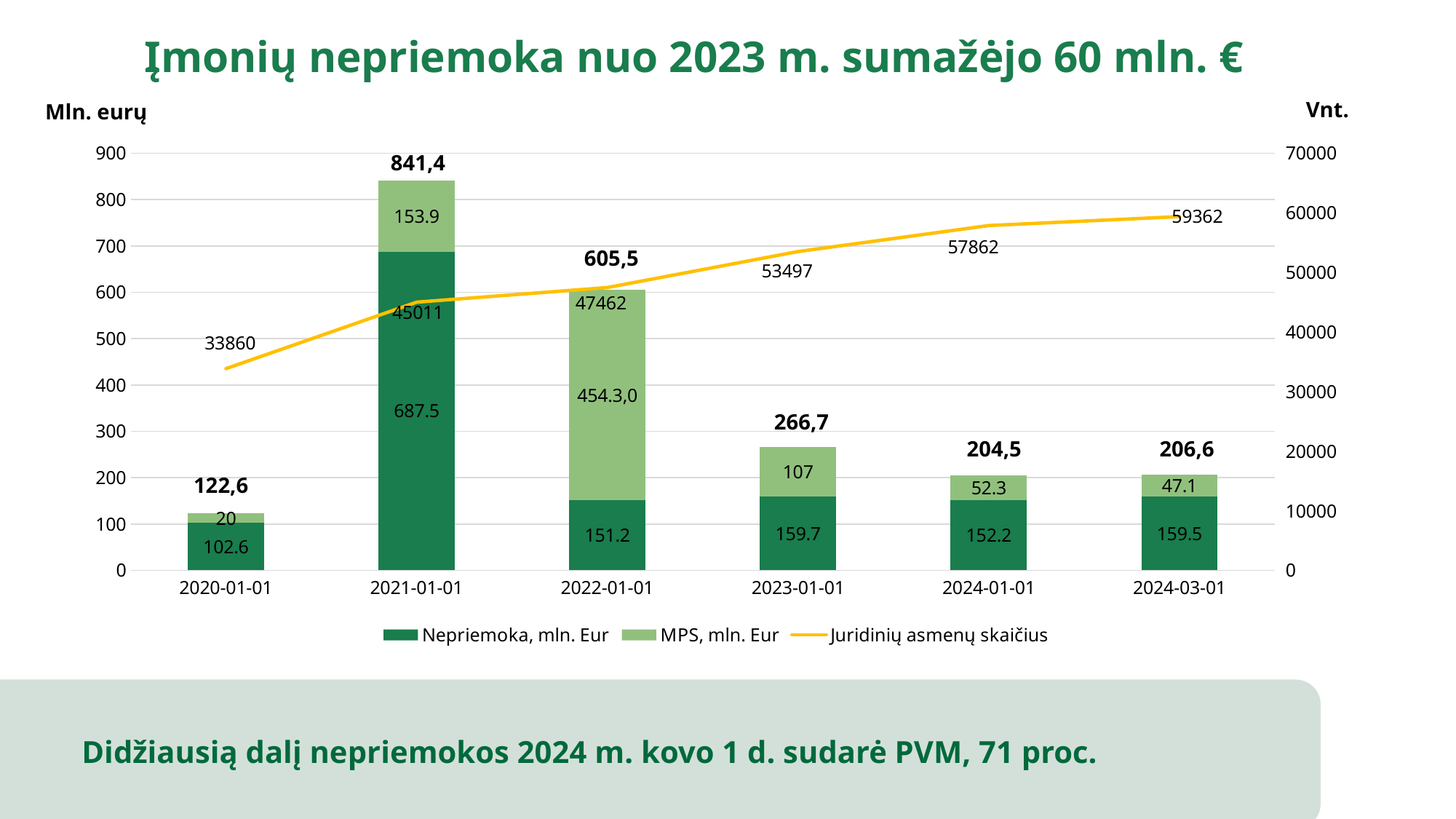
Which date has the highest total stacked bar value? 2021-01-01 What is the total labelled above the stacked bar for 2022-01-01? 605,5 What is the MPS, mln. Eur value for 2023-01-01? 107 What is the title of the chart? Įmonių nepriemoka nuo 2023 m. sumažėjo 60 mln. € How many series does the legend list? 3 What is the Nepriemoka, mln. Eur value for 2021-01-01? 687.5 How many dates are shown on the x axis? 6 Which date has the lowest total stacked bar value? 2020-01-01 What is the Juridinių asmenų skaičius value for 2024-03-01? 59362 Does the Juridinių asmenų skaičius line rise or fall from 2020-01-01 to 2024-03-01? rise What is the difference between the Juridinių asmenų skaičius values for 2024-01-01 and 2023-01-01? 4365 Which is larger, the MPS, mln. Eur value for 2024-01-01 or for 2024-03-01? 2024-01-01